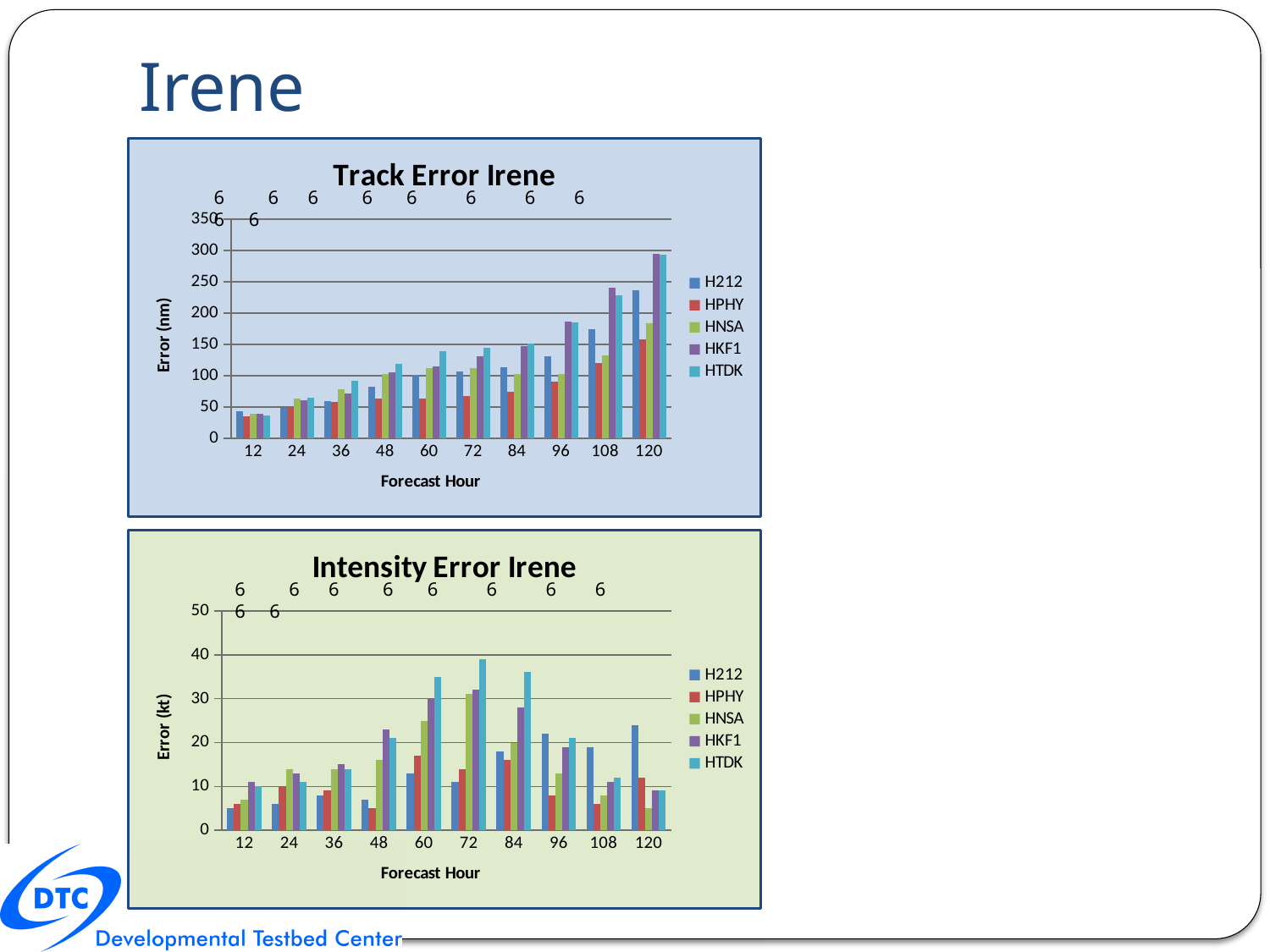
How many forecast hour categories are shown on the x axis of the Intensity Error Irene chart? 10 In the Intensity Error Irene chart, which series has the highest value at forecast hour 72? HTDK In the Track Error Irene chart, is the value for H212 at forecast hour 120 greater or less than 200? greater What is the y-axis label of the Intensity Error Irene chart? Error (kt) What type of chart is the Track Error Irene chart? bar chart In the Intensity Error Irene chart, is the value for HNSA at forecast hour 120 greater or less than 10? less In the Track Error Irene chart, does the H212 track error generally rise or fall as the forecast hour increases? rise In the Track Error Irene chart, is the value for HPHY at forecast hour 12 greater or less than 50? less In the Track Error Irene chart, which series has the lowest value at forecast hour 120? HPHY In the Intensity Error Irene chart, which is larger at forecast hour 84: HKF1 or HTDK? HTDK How many series does the legend of the Track Error Irene chart list? 5